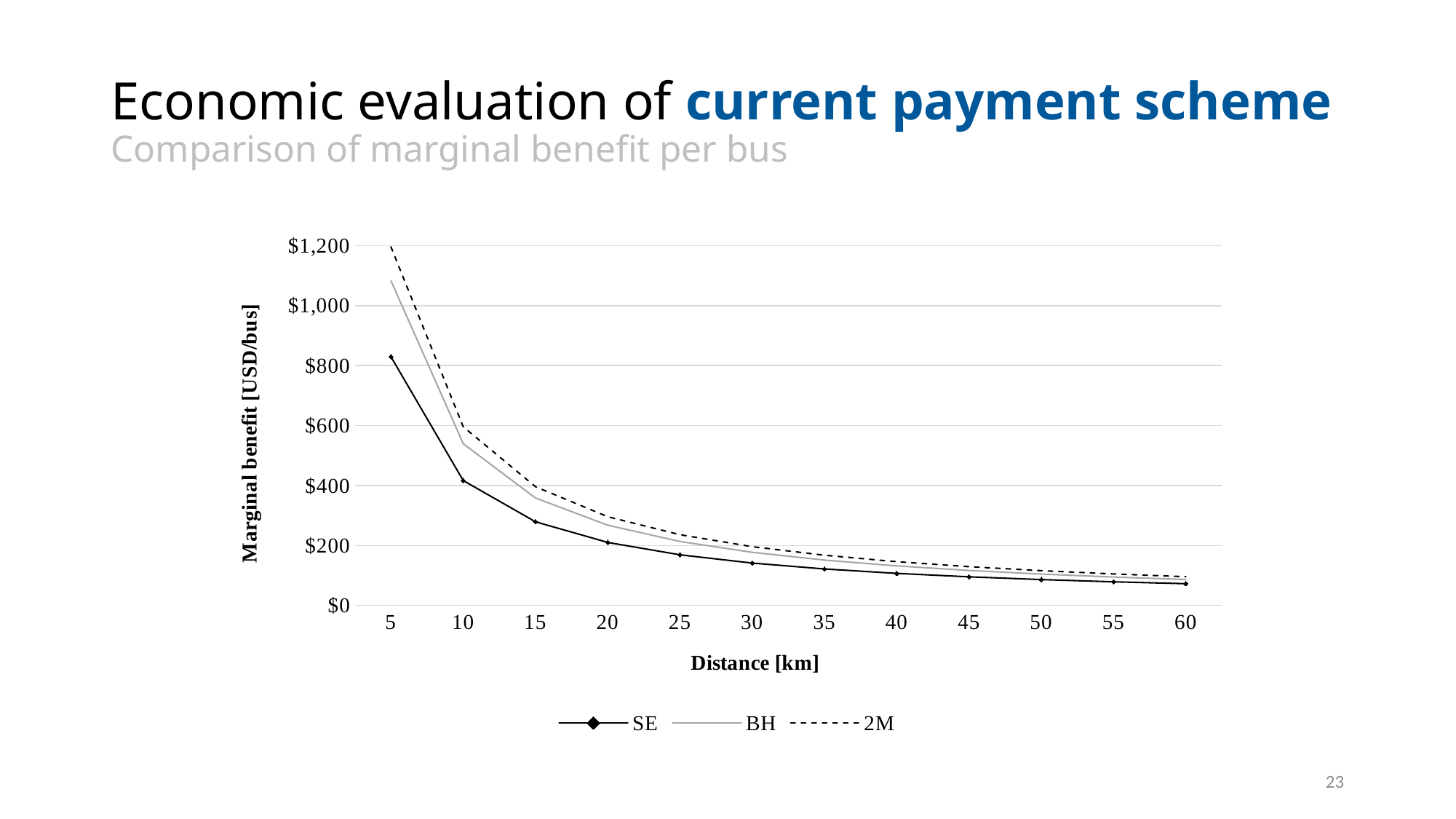
Do the marginal benefit values rise or fall as distance increases? Fall What kind of chart is shown on the slide? Line chart Is the value for SE at 60 km greater or less than $200? less How many series does the legend list? 3 Which series has the highest marginal benefit at 5 km? 2M Is the value for 2M at 10 km greater or less than $400? greater At 10 km, which is larger, the value for BH or the value for SE? BH Is the value for SE at 5 km greater or less than $800? greater How many distance points are plotted along the x axis? 12 Which series has the lowest marginal benefit at 5 km? SE